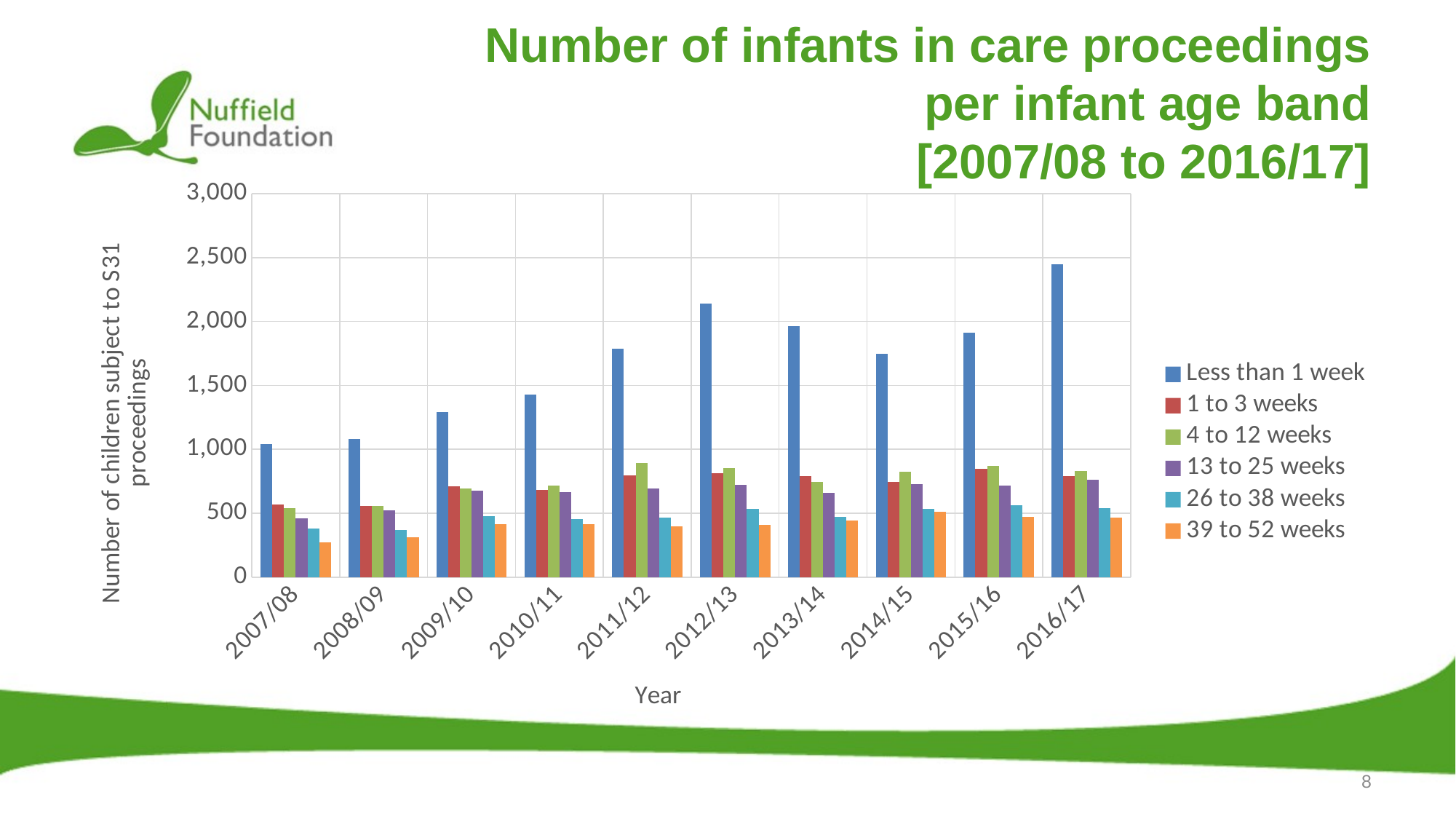
Overall, does the Less than 1 week series rise or fall from 2007/08 to 2016/17? rise Is the value for Less than 1 week in 2010/11 greater or less than 1,500? less What kind of chart is shown on the slide? bar chart What is the title of the y axis? Number of children subject to S31 proceedings Which is larger for Less than 1 week: the value in 2012/13 or in 2013/14? 2012/13 Is the value for 39 to 52 weeks in 2007/08 greater or less than 500? less Is the value for Less than 1 week in 2016/17 greater or less than 2,000? greater Which is larger for Less than 1 week: the value in 2015/16 or in 2016/17? 2016/17 How many series does the legend list? 6 In which year is the value for Less than 1 week highest? 2016/17 How many years are shown on the x axis? 10